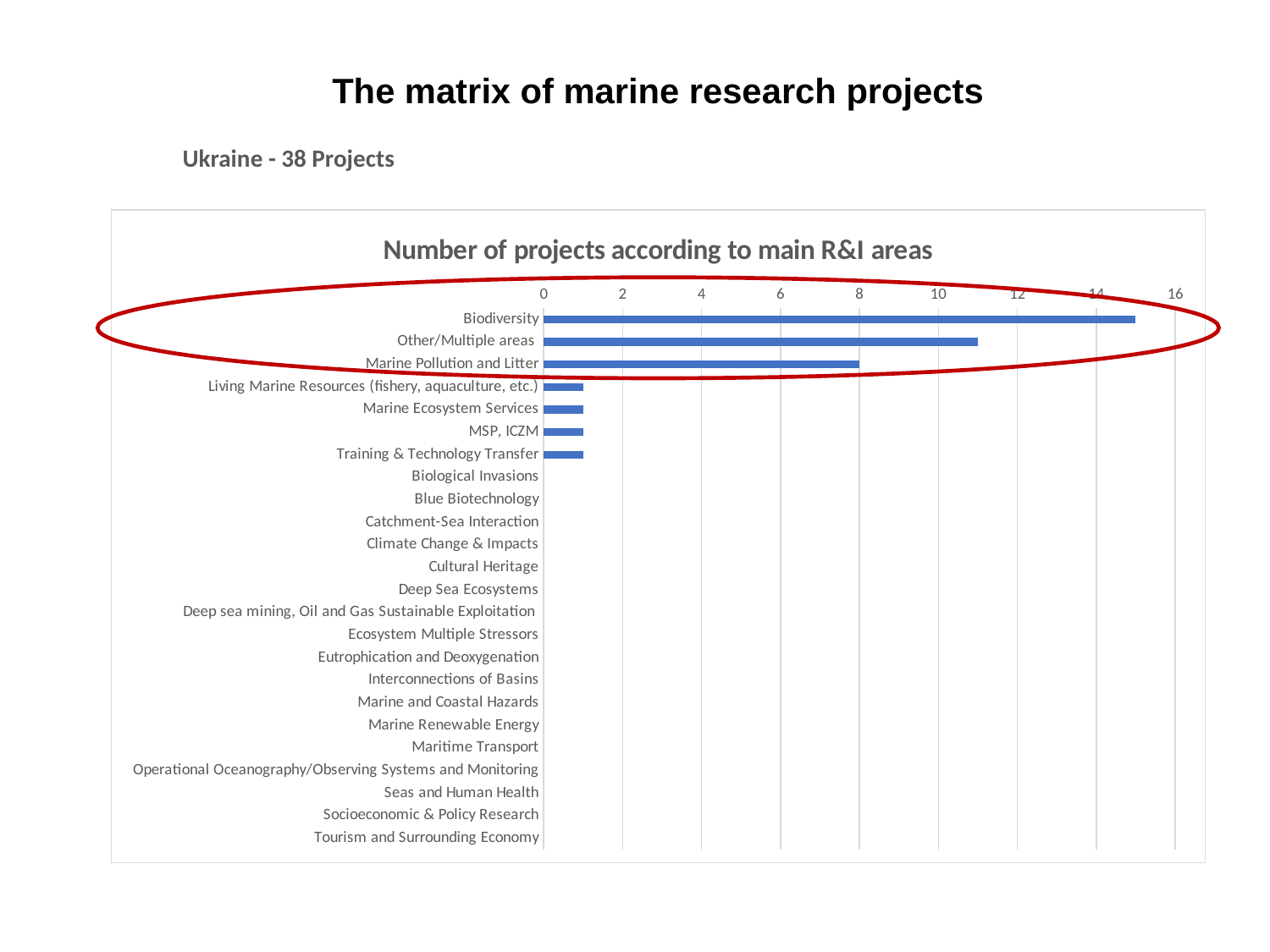
How many projects are shown for Marine Pollution and Litter? 8 What type of chart is shown on the slide? Bar chart Is the value for Other/Multiple areas greater or less than 12? less Which has more projects, Marine Pollution and Litter or MSP, ICZM? Marine Pollution and Litter How many R&I areas have a visible bar (a non-zero number of projects)? 7 Which has more projects, Biodiversity or Other/Multiple areas? Biodiversity Which R&I area has the highest number of projects? Biodiversity Is the value for Other/Multiple areas greater or less than 10? greater How many R&I area categories are listed on the chart's axis? 24 What is the title of the chart? Number of projects according to main R&I areas Is the value for Living Marine Resources (fishery, aquaculture, etc.) greater or less than 2? less